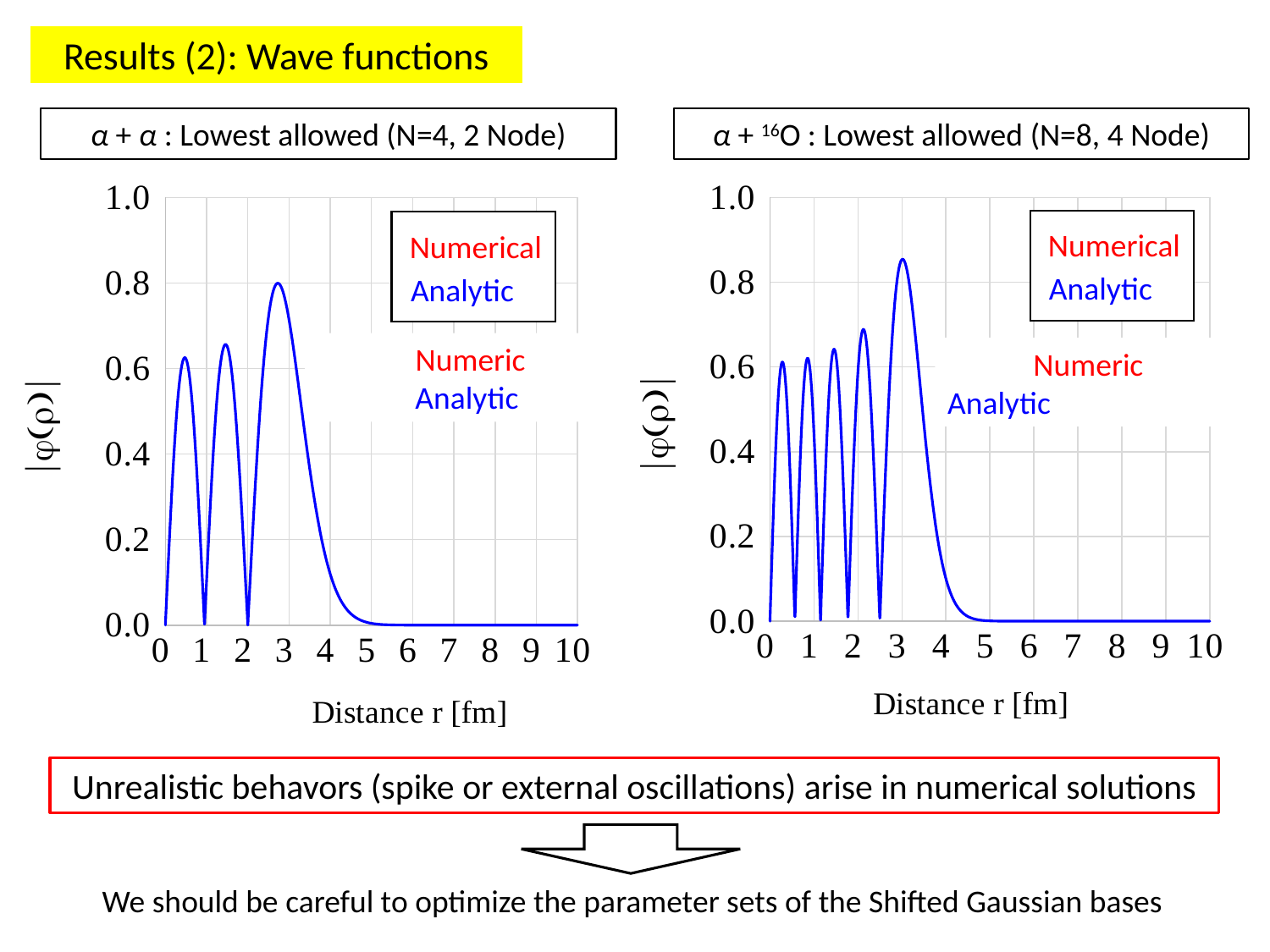
On the left chart (α + α), how many peaks does the blue curve have? 3 What is the x-axis label on the right chart (α + 16O)? Distance r [fm] What is the maximum value shown on the y-axis of the left chart (α + α)? 1.0 On the right chart (α + 16O), is the value of the curve at r = 7 fm greater or less than 0.2? less On the right chart (α + 16O), how many peaks does the blue curve have? 5 What type of chart is shown on the left (α + α) panel? line chart On the right chart (α + 16O), how does the curve behave for distances beyond about 5 fm? it stays flat near 0.0 On the right chart (α + 16O), is the highest peak of the curve greater or less than 0.8? greater On the left chart (α + α), which peak is higher: the one near r = 3 fm or the one near r = 0.5 fm? the one near r = 3 fm How many entries does the legend list on the left chart (α + α)? 2 On the left chart (α + α), is the value of the curve at r = 6 fm greater or less than 0.2? less